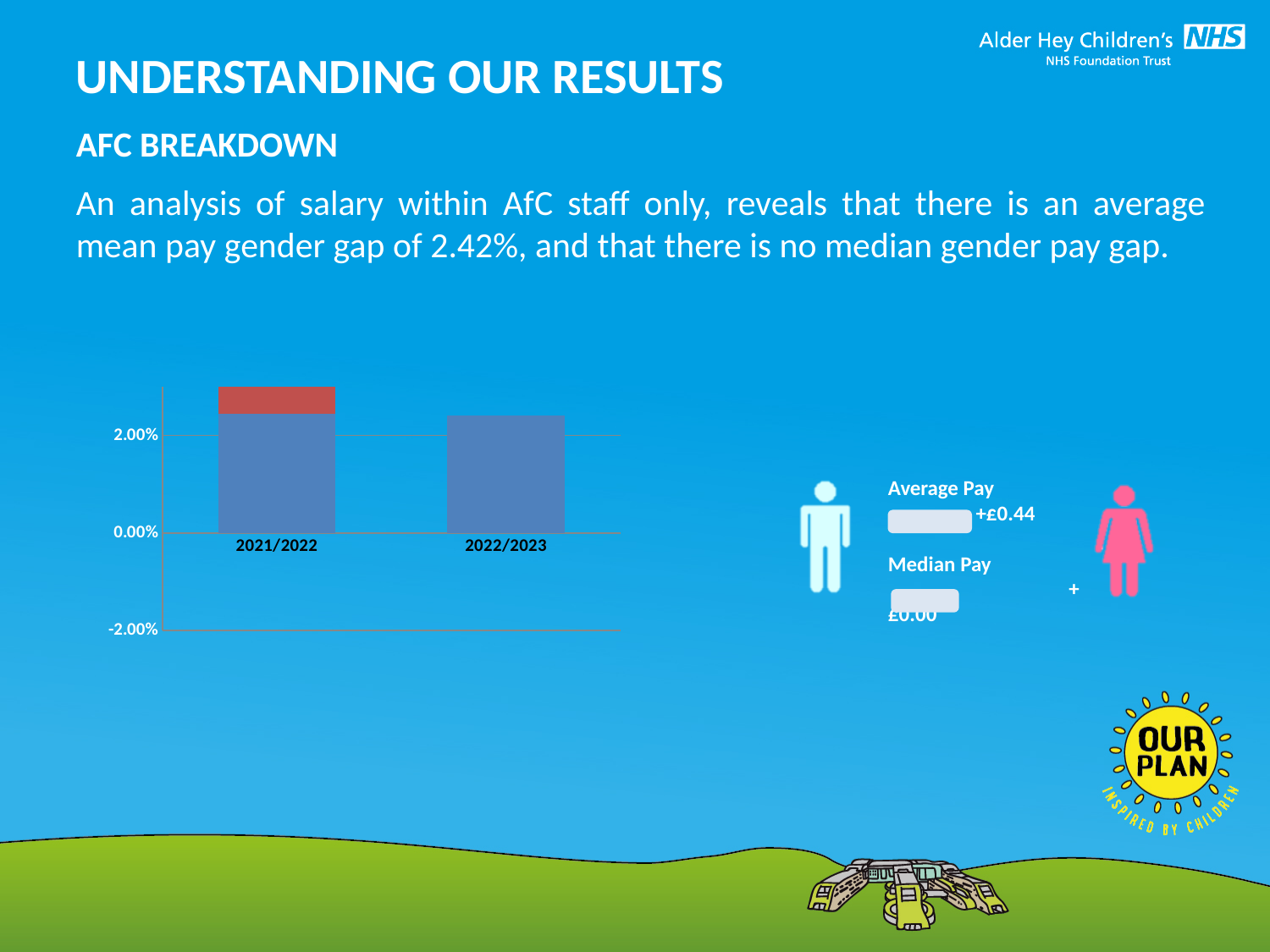
How many categories are shown on the x axis of the bar chart? 2 Is the value for 2022/2023 greater or less than 2.00%? greater Is the value for 2021/2022 greater or less than 2.00%? greater Which category's bar has a red segment on top of the blue segment? 2021/2022 Is the value for 2022/2023 greater or less than 0.00%? greater Which category has the lowest bar in the chart? 2022/2023 Do the bar heights rise or fall from 2021/2022 to 2022/2023? fall Which category has the highest bar in the chart? 2021/2022 What is the lowest tick label shown on the y axis of the chart? -2.00% What kind of chart is shown on the slide? bar chart Which category has the taller bar in the chart, 2021/2022 or 2022/2023? 2021/2022